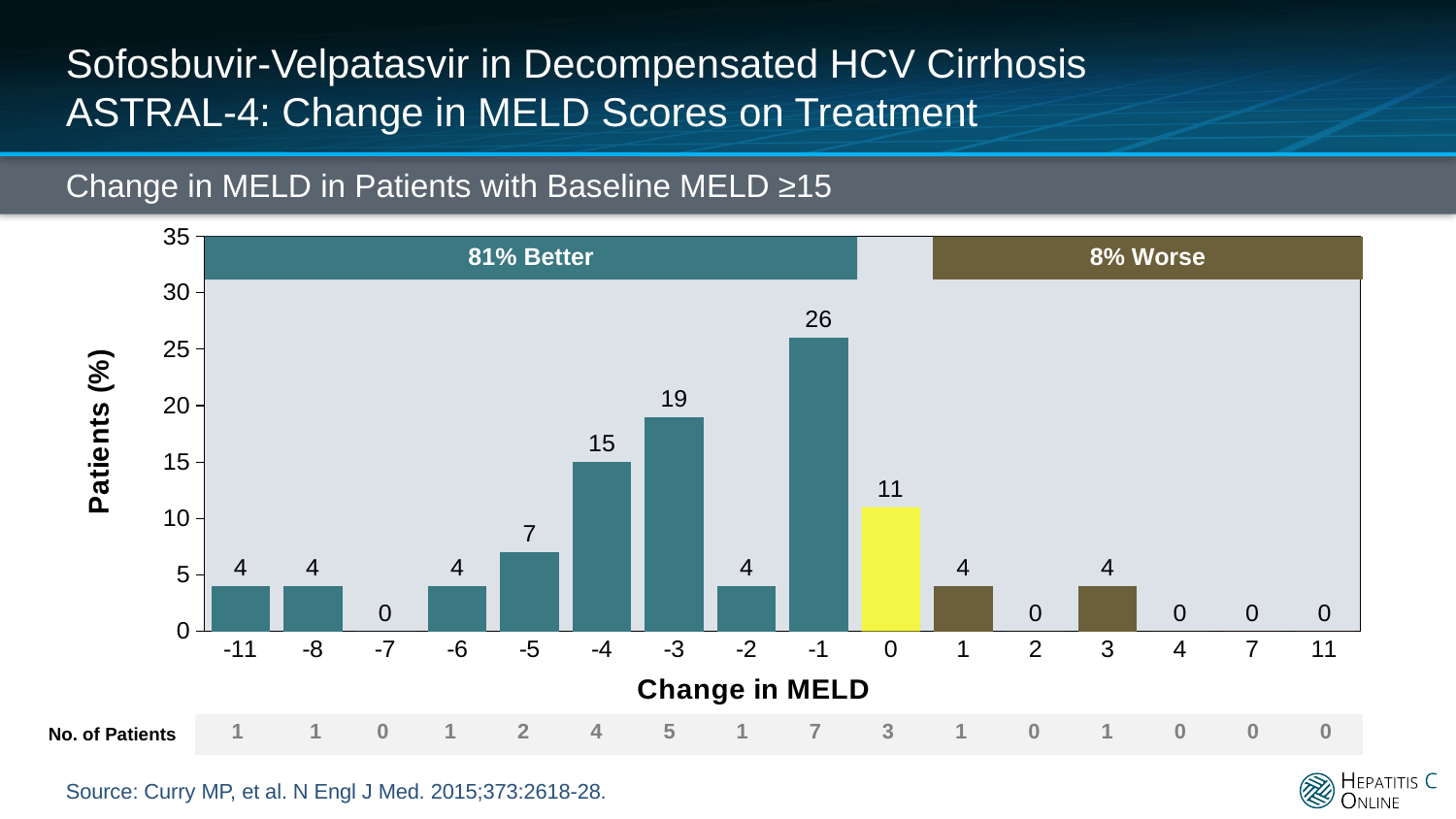
What percentage of patients had a change in MELD of 0? 11 What percentage of patients had a change in MELD of -1? 26 What is the number of patients with a change in MELD of -1 according to the 'No. of Patients' row? 7 What percentage of patients are labelled as 'Worse' on the chart? 8% What is the label of the y axis? Patients (%) Which change in MELD category has the highest percentage of patients? -1 Which has a higher percentage of patients: a change in MELD of -5 or -2? -5 How many change in MELD categories are shown on the x axis? 16 What is the difference in patients (%) between the -1 and -3 change in MELD categories? 7 What kind of chart is shown on the slide? Bar chart What percentage of patients had a change in MELD of -4? 15 What percentage of patients are labelled as 'Better' on the chart? 81%